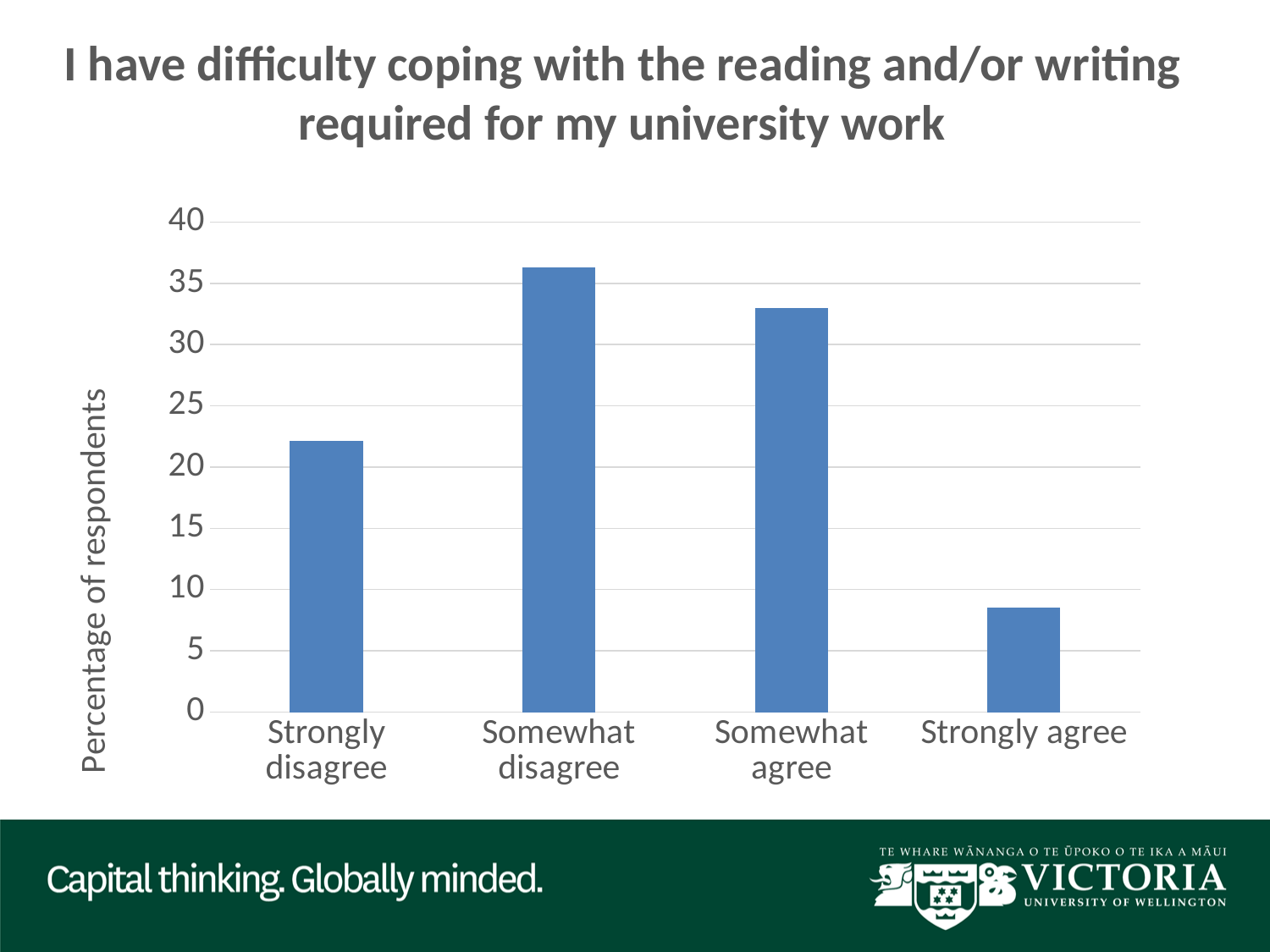
Is the value for Strongly agree greater or less than 10? less What is the label on the vertical axis of the chart? Percentage of respondents Which response category has the highest percentage of respondents? Somewhat disagree Is the value for Somewhat disagree greater or less than 30? greater How many response categories are shown on the x axis? 4 Which is larger, the value for Somewhat disagree or the value for Somewhat agree? Somewhat disagree What is the title of the chart? I have difficulty coping with the reading and/or writing required for my university work What kind of chart is shown on the slide? bar chart Is the value for Somewhat agree greater or less than 30? greater Which is larger, the value for Strongly disagree or the value for Strongly agree? Strongly disagree Which response category has the lowest percentage of respondents? Strongly agree